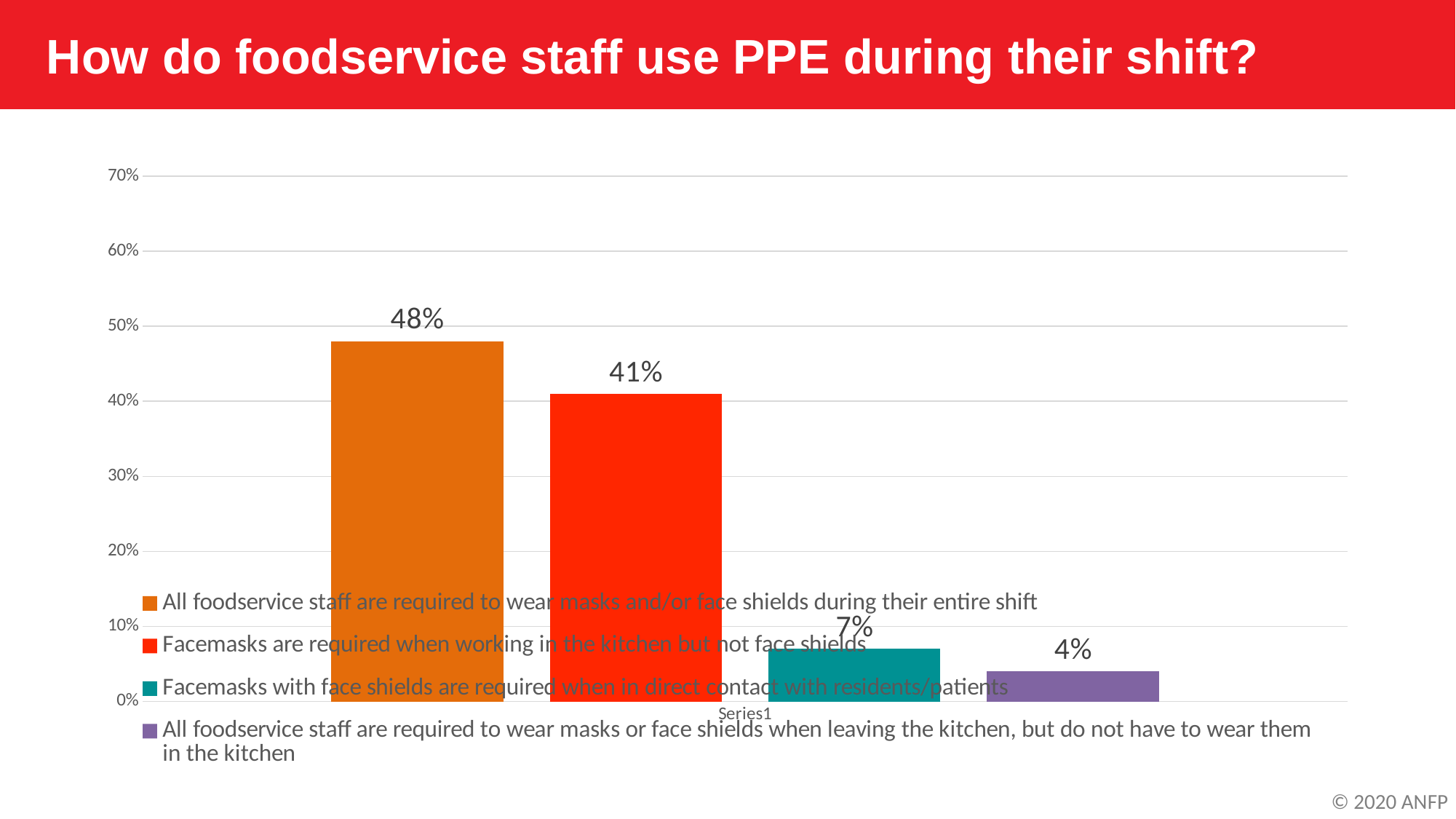
What percentage of respondents said facemasks with face shields are required when in direct contact with residents/patients? 7% Which PPE practice has the highest percentage? All foodservice staff are required to wear masks and/or face shields during their entire shift Which PPE practice has the lowest percentage? All foodservice staff are required to wear masks or face shields when leaving the kitchen, but do not have to wear them in the kitchen What is the difference in percentage points between the 'entire shift' response and the 'kitchen but not face shields' response? 7 Which is larger: the share for facemasks with face shields in direct contact with residents/patients, or the share for masks only when leaving the kitchen? Facemasks with face shields are required when in direct contact with residents/patients What percentage of respondents said all foodservice staff are required to wear masks and/or face shields during their entire shift? 48% What kind of chart is shown on the slide? Bar chart How many series does the legend list? 4 What percentage of respondents said facemasks are required when working in the kitchen but not face shields? 41% Is the value for facemasks required in the kitchen but not face shields greater or less than 40%? greater What colour is the bar for 'Facemasks are required when working in the kitchen but not face shields'? Red What percentage of respondents said staff are required to wear masks or face shields when leaving the kitchen, but not in the kitchen? 4%